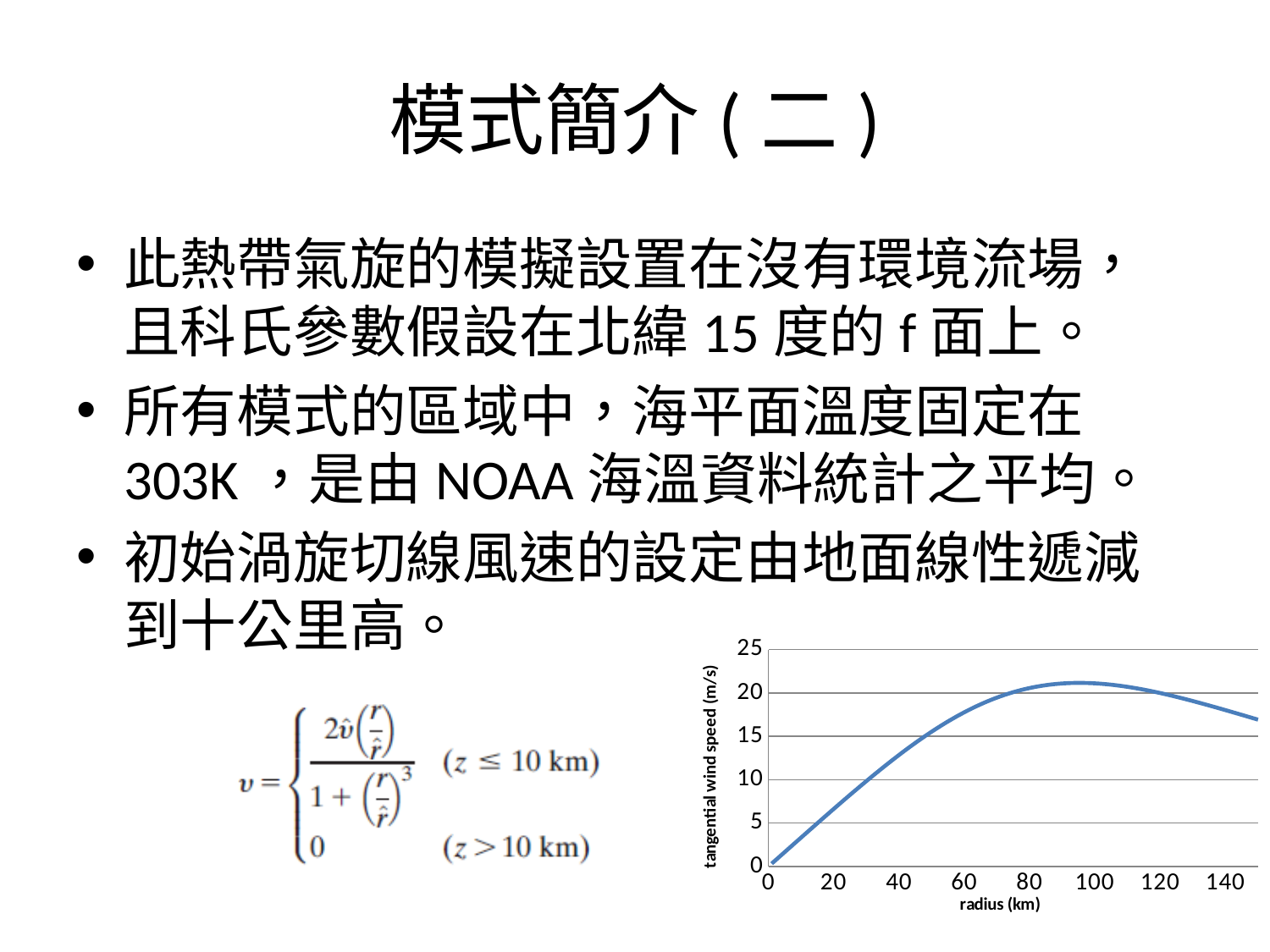
What kind of chart is shown on the slide? line chart Is the maximum tangential wind speed on the curve greater or less than 25 m/s? less Between which two x-axis ticks does the tangential wind speed reach its maximum? 80 and 100 Is the tangential wind speed at a radius of 40 km greater or less than 15 m/s? less Is the tangential wind speed at a radius of 140 km greater or less than 15 m/s? greater What is the label of the y axis of the chart? tangential wind speed (m/s) How does the tangential wind speed change as the radius increases from 0 to 150 km? rises then falls What is the label of the x axis of the chart? radius (km)